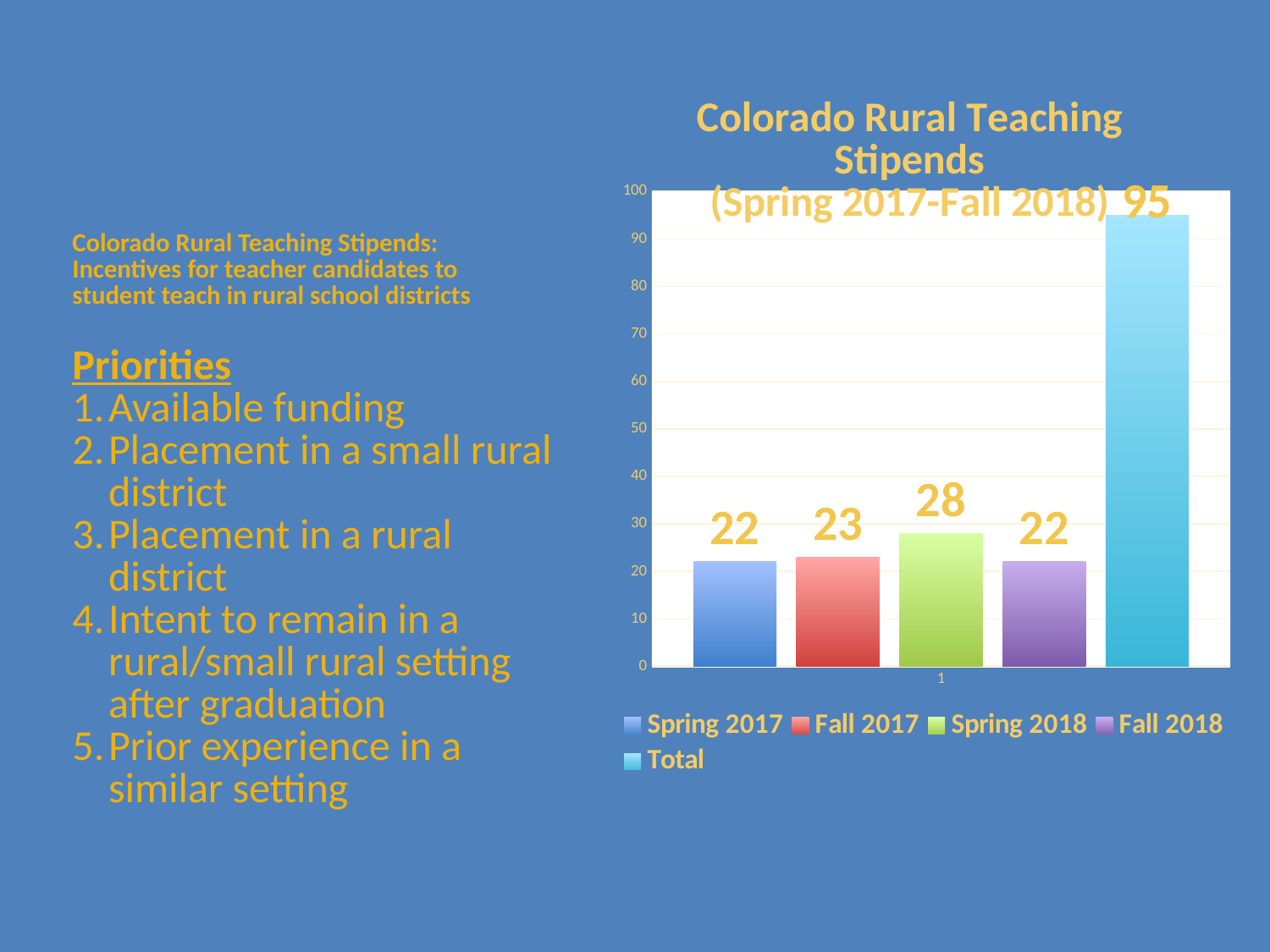
What is the value for Fall 2017? 23 Which series has the highest value? Total What kind of chart is shown on the slide? Bar chart What is the value for Total? 95 What is the difference between the Spring 2018 value and the Fall 2018 value? 6 Among the four semesters (excluding Total), which has the highest value? Spring 2018 What is the value for Spring 2017? 22 How many series does the legend list? 5 What is the difference between the Total value and the Spring 2018 value? 67 What is the title of the chart? Colorado Rural Teaching Stipends (Spring 2017-Fall 2018) What is the value for Spring 2018? 28 Which is larger, the value for Fall 2017 or the value for Spring 2018? Spring 2018